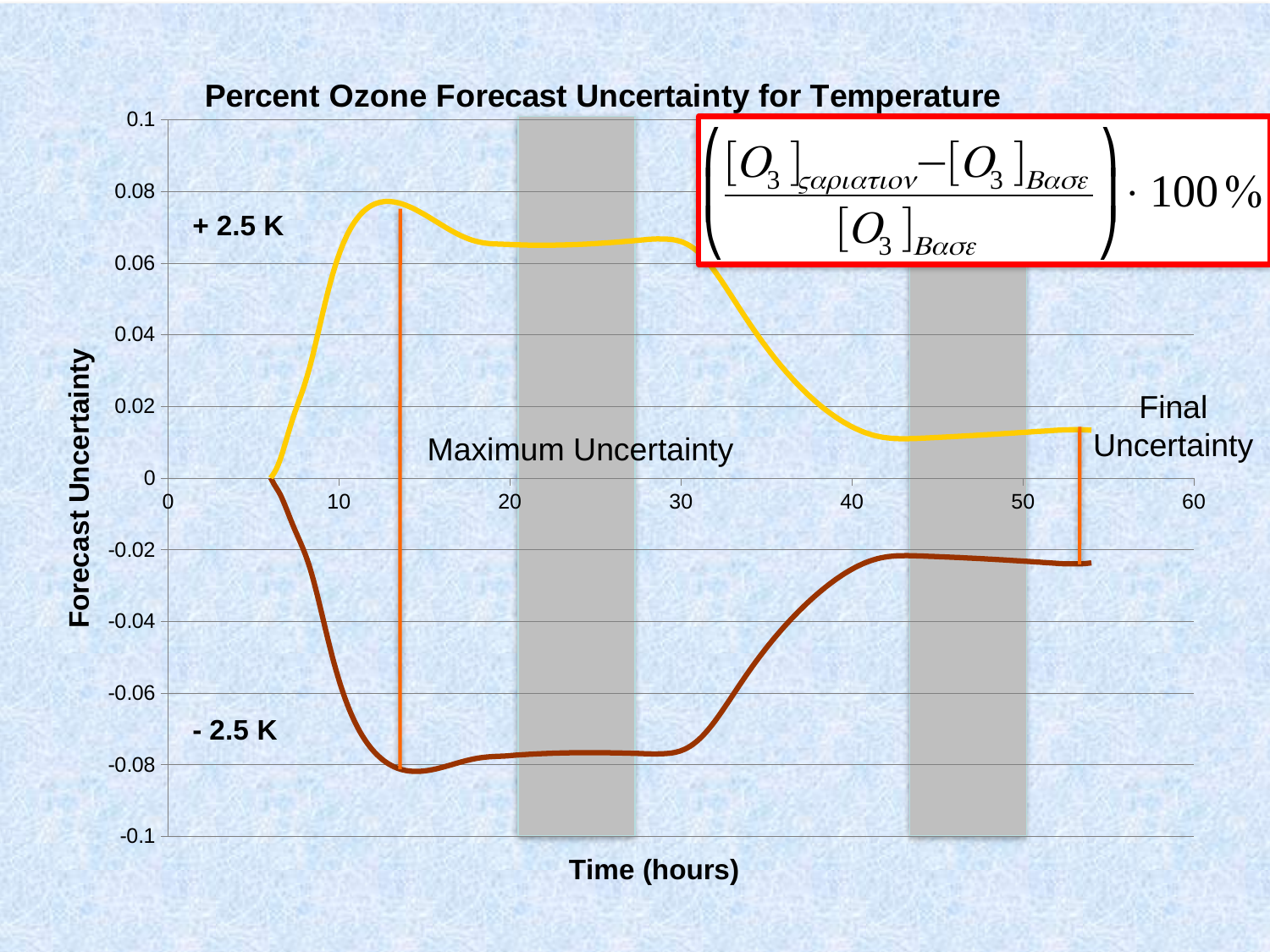
Is the peak value of the + 2.5 K line greater or less than 0.06? greater Between 30 and 40 hours, does the - 2.5 K line rise or fall? rise Is the value of the - 2.5 K line at 50 hours greater or less than -0.04? greater How many series (lines) are plotted on the chart? 2 Is the value of the + 2.5 K line at 40 hours greater or less than 0.04? less Between 30 and 40 hours, does the + 2.5 K line rise or fall? fall What is the label of the x axis? Time (hours) What kind of chart is shown on the slide? line chart What is the title of the chart? Percent Ozone Forecast Uncertainty for Temperature At 20 hours, which line has the larger value, + 2.5 K or - 2.5 K? + 2.5 K